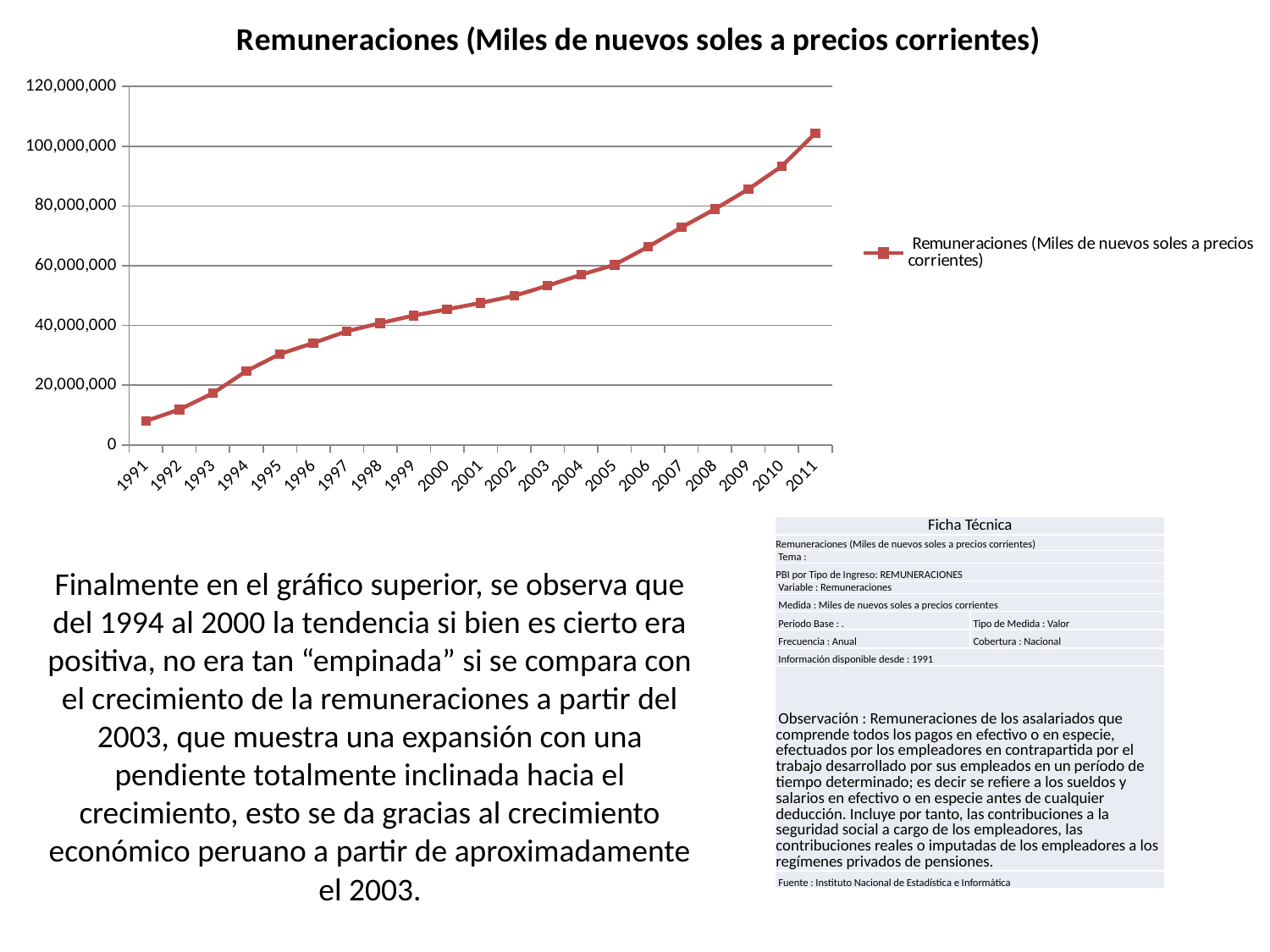
Is the value for 2009 greater or less than 80,000,000? greater Is the value for 2003 greater or less than 60,000,000? less How many series does the legend list? 1 Which year has the highest value for Remuneraciones? 2011 Do the values rise or fall from 1991 to 2011? Rise How many years are plotted on the x axis? 21 What kind of chart is shown on the slide? Line chart Which year has the larger value, 2006 or 2001? 2006 What is the title of the chart? Remuneraciones (Miles de nuevos soles a precios corrientes) Is the value for 2011 greater or less than 100,000,000? greater Which year has the lowest value for Remuneraciones? 1991